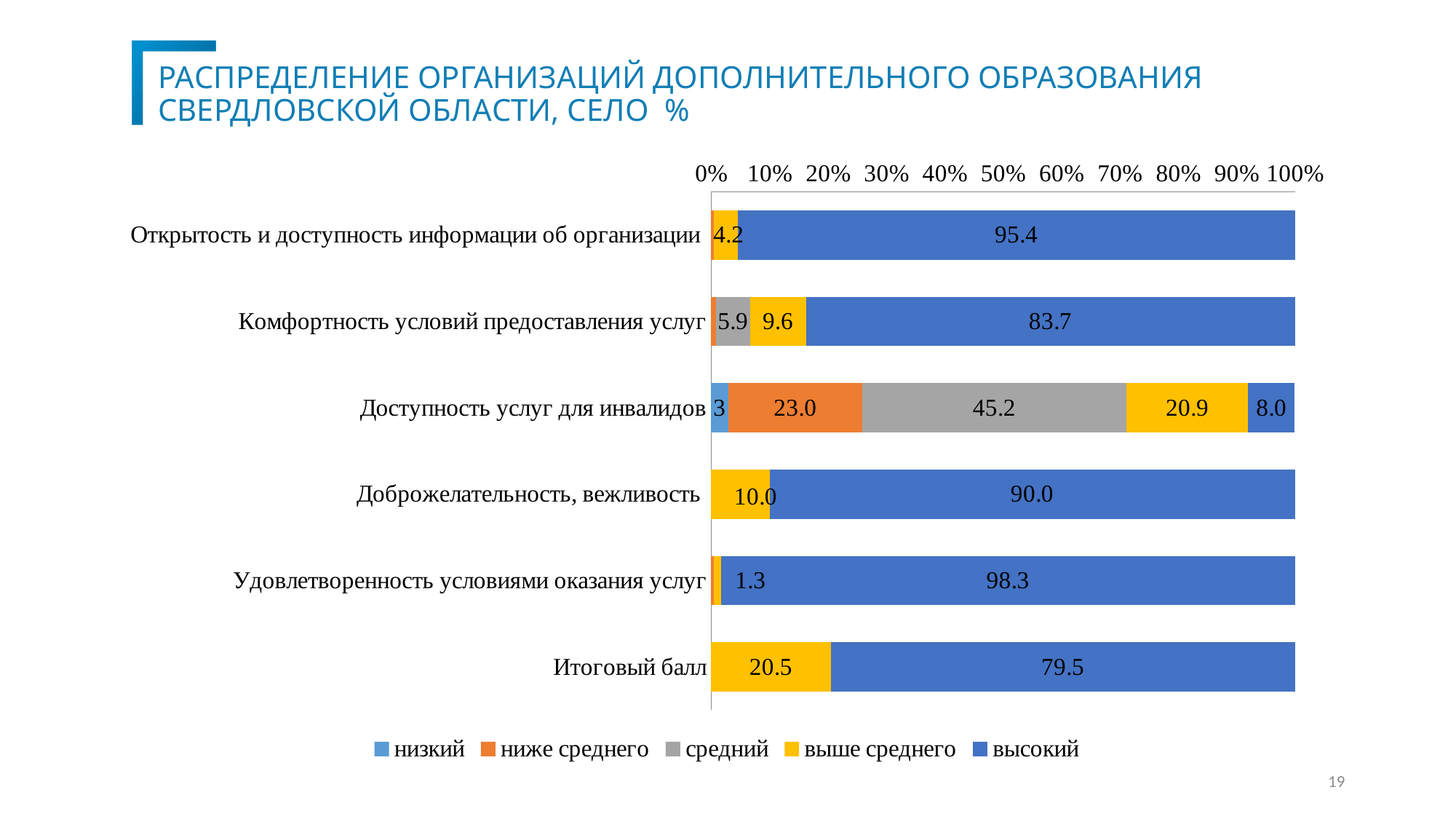
Which category has the highest 'высокий' value? Удовлетворенность условиями оказания услуг What is the value of the 'высокий' segment for 'Открытость и доступность информации об организации'? 95.4 Which is larger: the 'выше среднего' value for 'Комфортность условий предоставления услуг' or for 'Доброжелательность, вежливость'? Доброжелательность, вежливость What type of chart is shown on the slide? Stacked bar chart How many series does the legend list? 5 What is the difference between the 'высокий' values for 'Доброжелательность, вежливость' and 'Итоговый балл'? 10.5 What is the value of the 'выше среднего' segment for 'Итоговый балл'? 20.5 Which category has the lowest 'высокий' value? Доступность услуг для инвалидов What is the value of the 'средний' segment for 'Доступность услуг для инвалидов'? 45.2 Which legend entry is shown in grey? средний How many categories are shown on the chart? 6 What is the value of the 'ниже среднего' segment for 'Доступность услуг для инвалидов'? 23.0